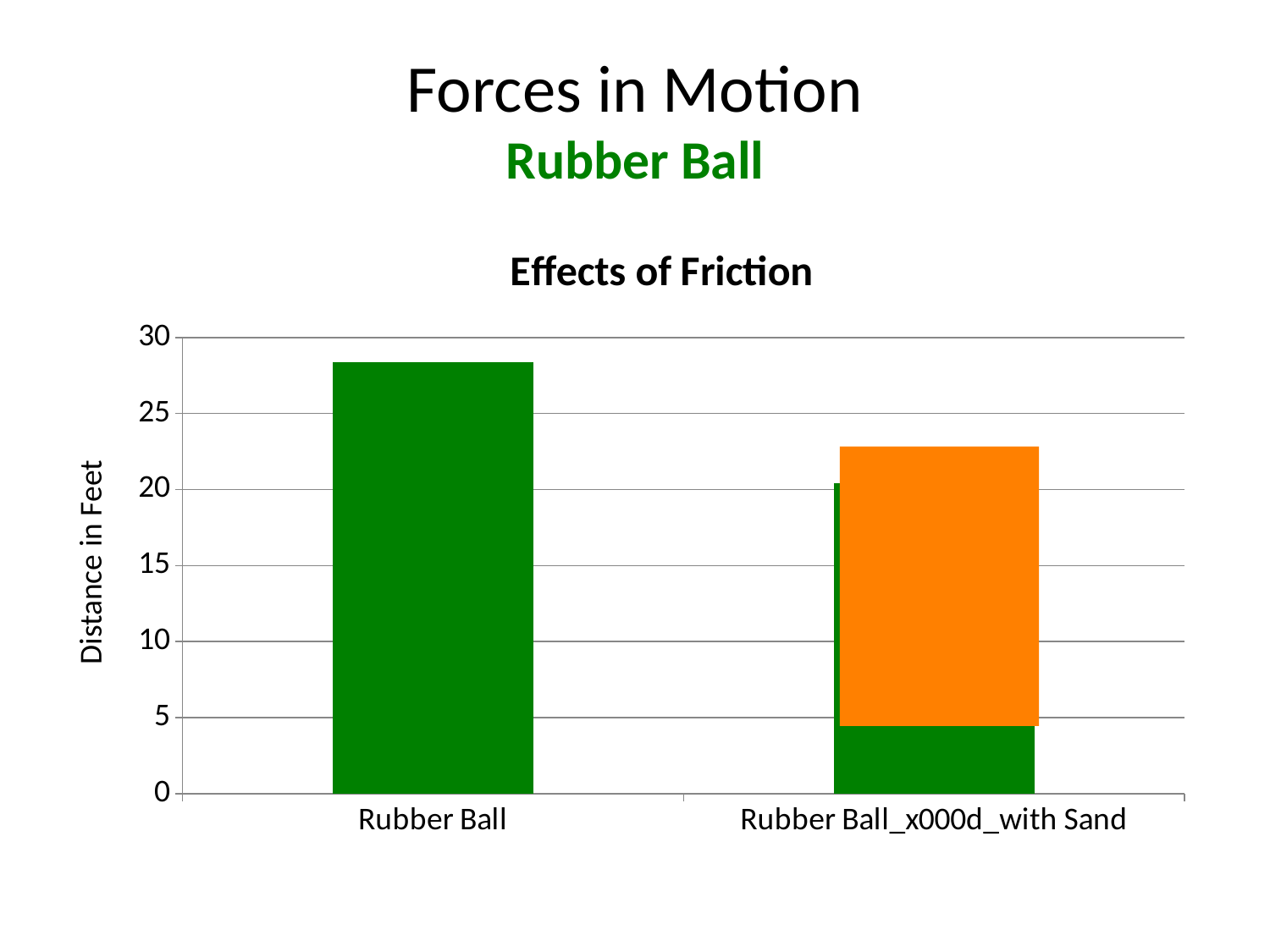
Which category has the lowest value in the chart? Rubber Ball_x000d_with Sand Is the value for Rubber Ball_x000d_with Sand greater or less than 25? less What is the title of the chart? Effects of Friction How many categories are shown on the x axis of the chart? 2 What kind of chart is shown on the slide? bar chart Is the value for Rubber Ball_x000d_with Sand greater or less than 15? greater What is the label on the vertical axis of the chart? Distance in Feet Which is larger: the value for Rubber Ball or the value for Rubber Ball_x000d_with Sand? Rubber Ball Is the value for Rubber Ball greater or less than 25? greater Which category has the highest value in the chart? Rubber Ball Do the values fall or rise from the first category to the second along the x axis? fall